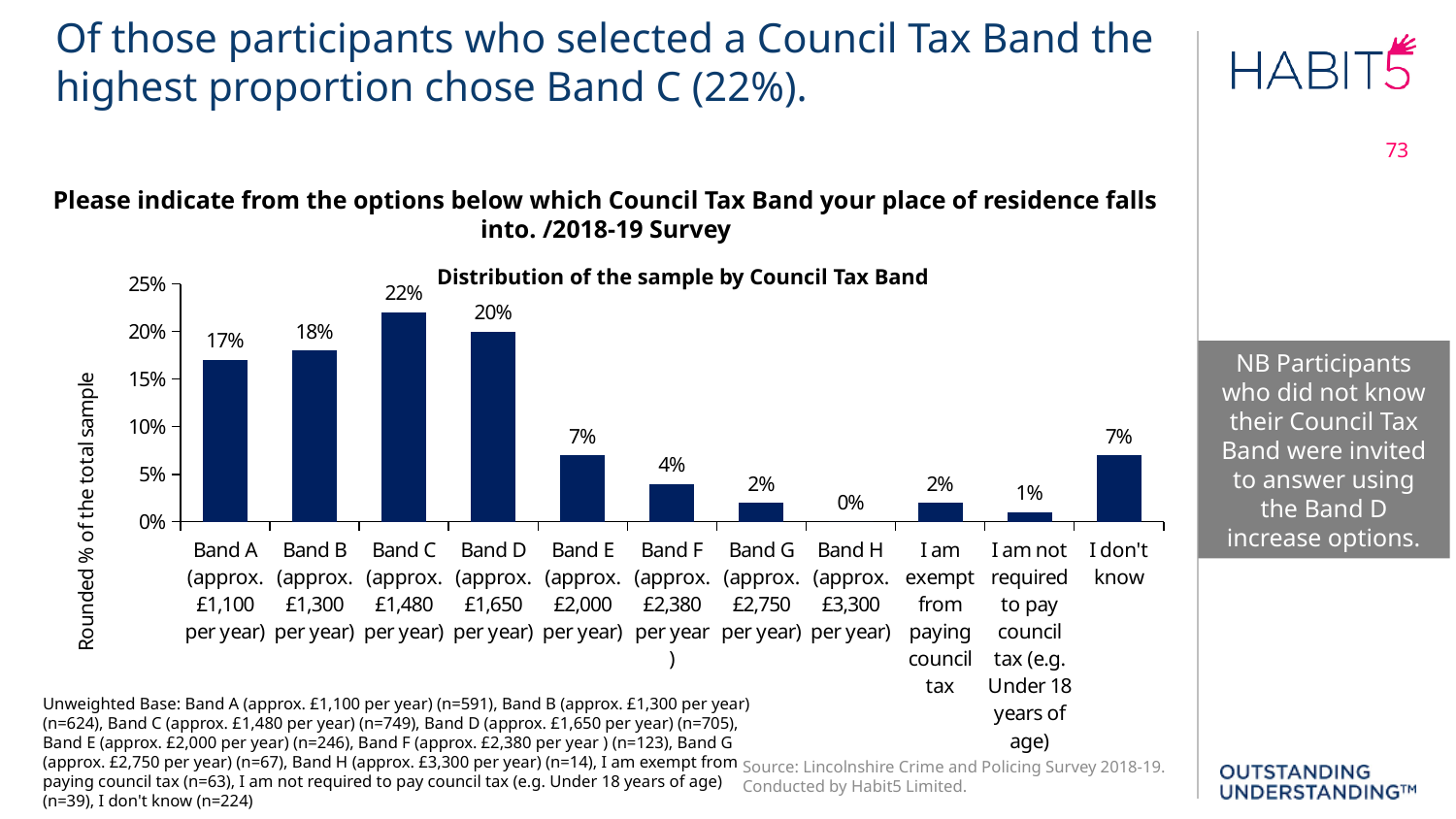
What is the label on the y axis of the chart? Rounded % of the total sample What percentage of the sample selected 'I don't know'? 7% What is the difference in percentage points between Band C and Band D? 2% What is the value shown for Band H? 0% What percentage of the sample is in Band C? 22% Which category has the lowest percentage? Band H Which Council Tax Band category has the highest percentage? Band C What is the title of the chart? Distribution of the sample by Council Tax Band How many categories are shown on the x axis of the chart? 11 What is the difference between Band A and Band E? 10% Which is larger, the value for Band B or the value for Band F? Band B What type of chart is shown on the slide? Bar chart